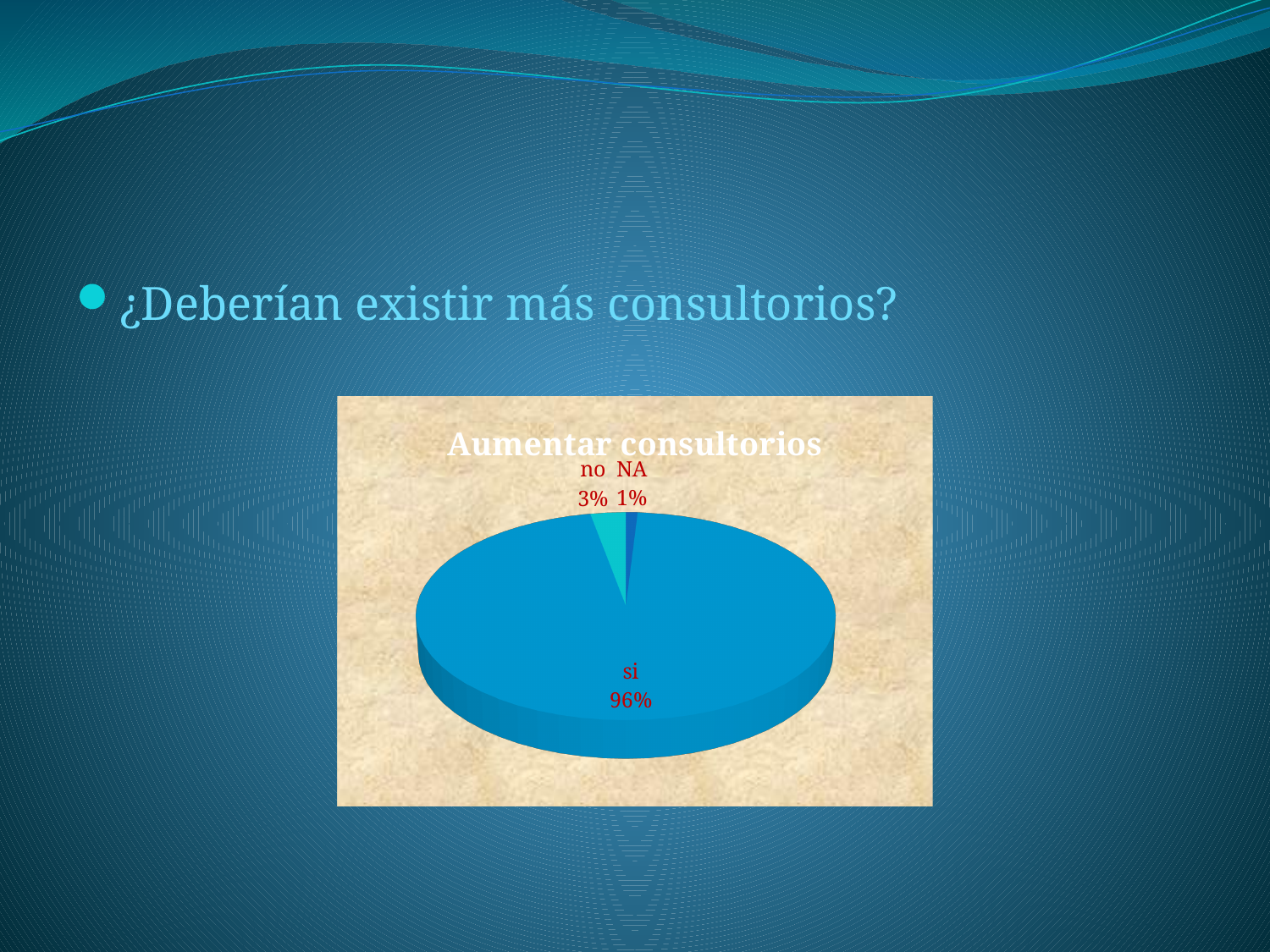
What kind of chart is shown on the slide? pie chart Which slice of the pie is the smallest? NA What percentage of the pie is labelled "no"? 3% Which slice of the pie is the largest? si What percentage of the pie is labelled "si"? 96% How many slices does the pie chart have? 3 What percentage of the pie is labelled "NA"? 1% What is the combined share of the "no" and "NA" slices? 4% What is the title of the chart? Aumentar consultorios Which is larger, the "no" slice or the "NA" slice? no Is the share for "si" greater or less than 50%? greater What is the difference in percentage points between the "si" slice and the "no" slice? 93